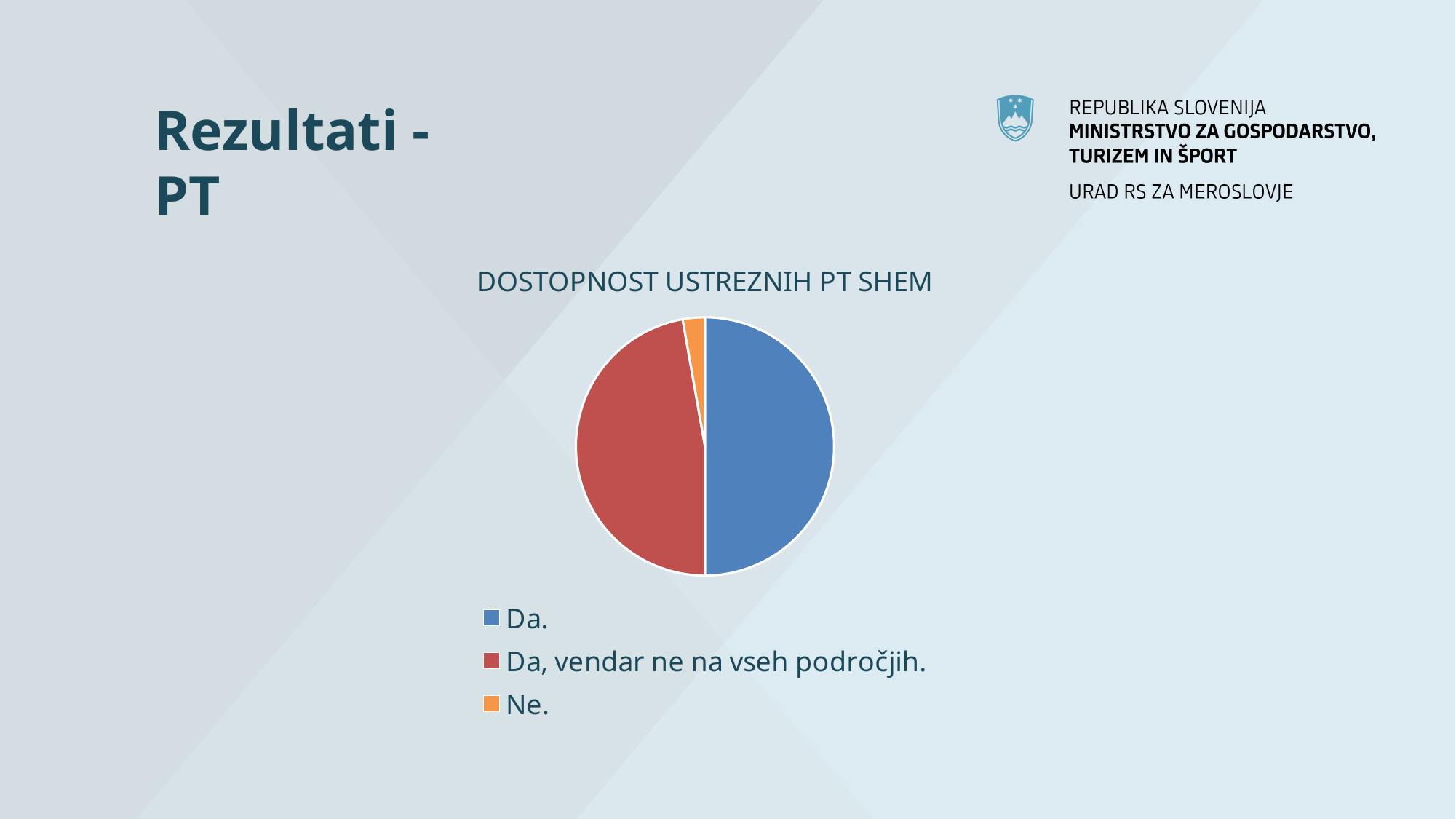
How many entries does the legend list? 3 Which slice is larger: "Da, vendar ne na vseh področjih." or "Ne."? Da, vendar ne na vseh področjih. Which category has the smallest slice of the pie? Ne. What kind of chart is shown on the slide? pie chart What colour is the slice for "Ne."? orange Which slice is larger: "Da." or "Ne."? Da. What is the title of the chart? DOSTOPNOST USTREZNIH PT SHEM How many categories (slices) does the pie chart have? 3